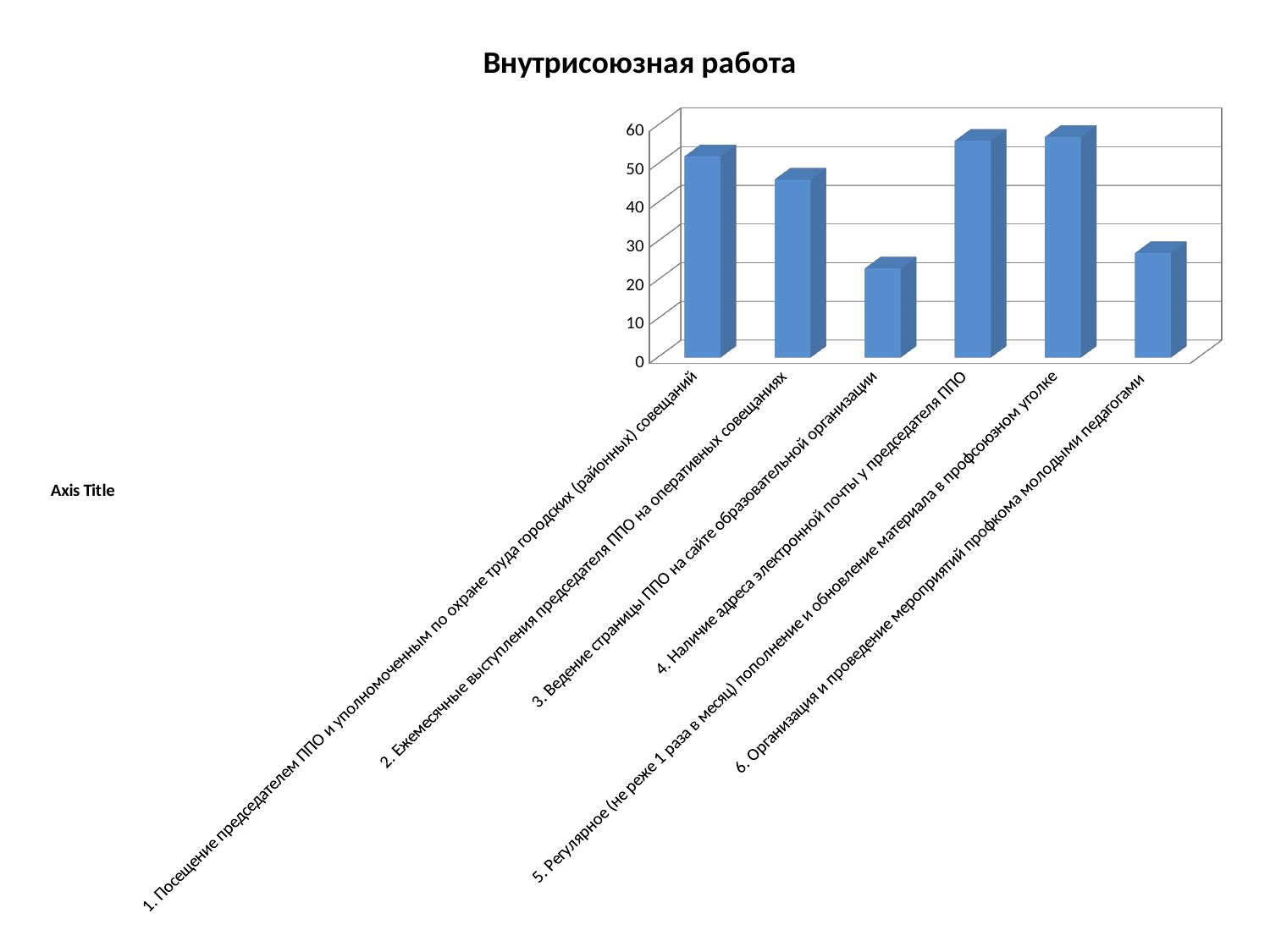
Which is larger: the value for category 6 or the value for category 2? Category 2 Is the value for category 6 (Организация и проведение мероприятий профкома молодыми педагогами) greater or less than 40? less Which category has the lowest value? 3. Ведение страницы ППО на сайте образовательной организации How many categories are plotted in the chart? 6 What is the title of the chart? Внутрисоюзная работа Is the value for category 1 (Посещение председателем ППО и уполномоченным по охране труда городских (районных) совещаний) greater or less than 40? greater What text is shown as the axis title on the left of the slide? Axis Title Is the value for category 3 (Ведение страницы ППО на сайте образовательной организации) greater or less than 30? less Which is larger: the value for category 1 or the value for category 3? Category 1 What kind of chart is shown on the slide? Bar chart